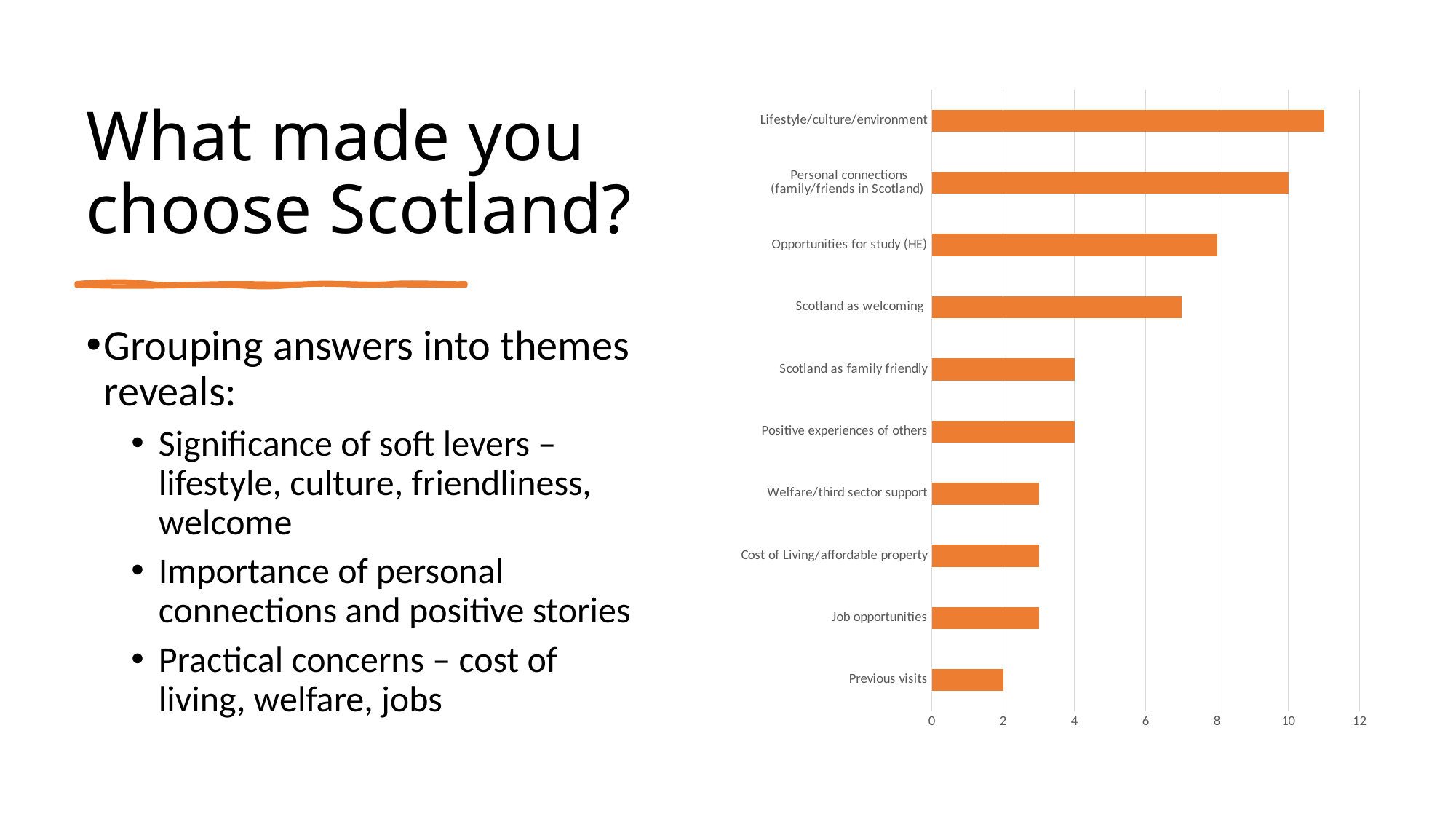
Which is larger: the value for Scotland as welcoming or the value for Positive experiences of others? Scotland as welcoming What is the value for Previous visits? 2 How many categories does the bar chart show? 10 What is the value for Personal connections (family/friends in Scotland)? 10 What kind of chart is shown on the slide? bar chart Is the value for Welfare/third sector support greater or less than 4? less What is the value for Scotland as family friendly? 4 Which category has the highest value in the chart? Lifestyle/culture/environment Is the value for Lifestyle/culture/environment greater or less than 10? greater What is the difference between the values for Personal connections (family/friends in Scotland) and Opportunities for study (HE)? 2 Which category has the lowest value in the chart? Previous visits What is the value for Opportunities for study (HE)? 8